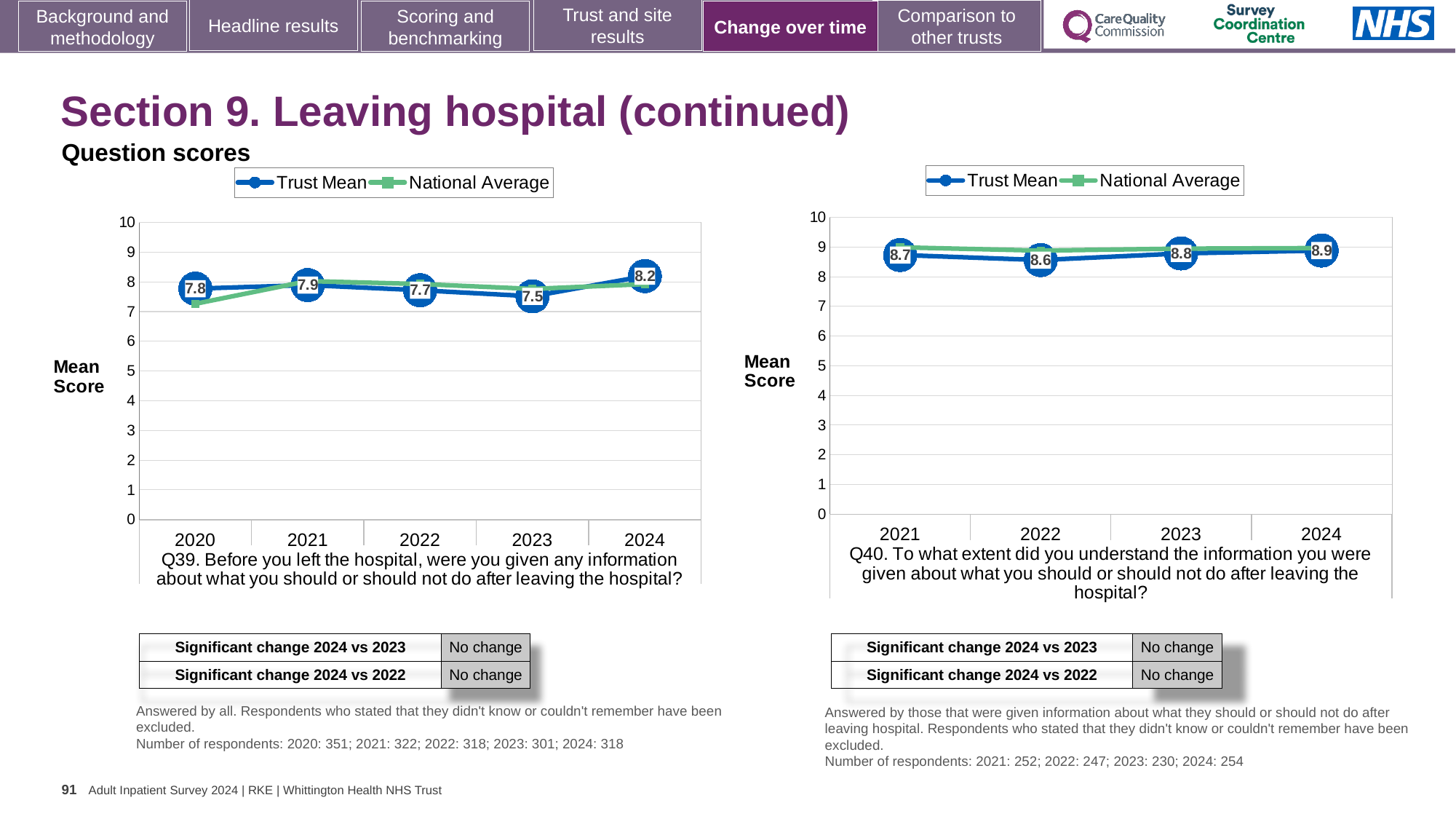
On the Q40 chart (right), what is the Trust Mean score for 2022? 8.6 On the Q39 chart (left), what is the Trust Mean score for 2023? 7.5 On the Q40 chart (right), is the National Average value for 2021 greater or less than 8? greater On the Q40 chart (right), is the Trust Mean score for 2021 or 2023 larger? 2023 On the Q39 chart (left), what is the Trust Mean score for 2024? 8.2 On the Q39 chart (left), how many years are shown on the x axis? 5 On the Q39 chart (left), which year has the lowest Trust Mean score? 2023 What kind of chart is the Q39 chart (left)? Line chart On the Q39 chart (left), which year has the highest Trust Mean score? 2024 On the Q40 chart (right), which year has the highest Trust Mean score? 2024 On the Q39 chart (left), what is the difference between the Trust Mean scores for 2024 and 2023? 0.7 How many series does the legend of the Q40 chart (right) list? 2